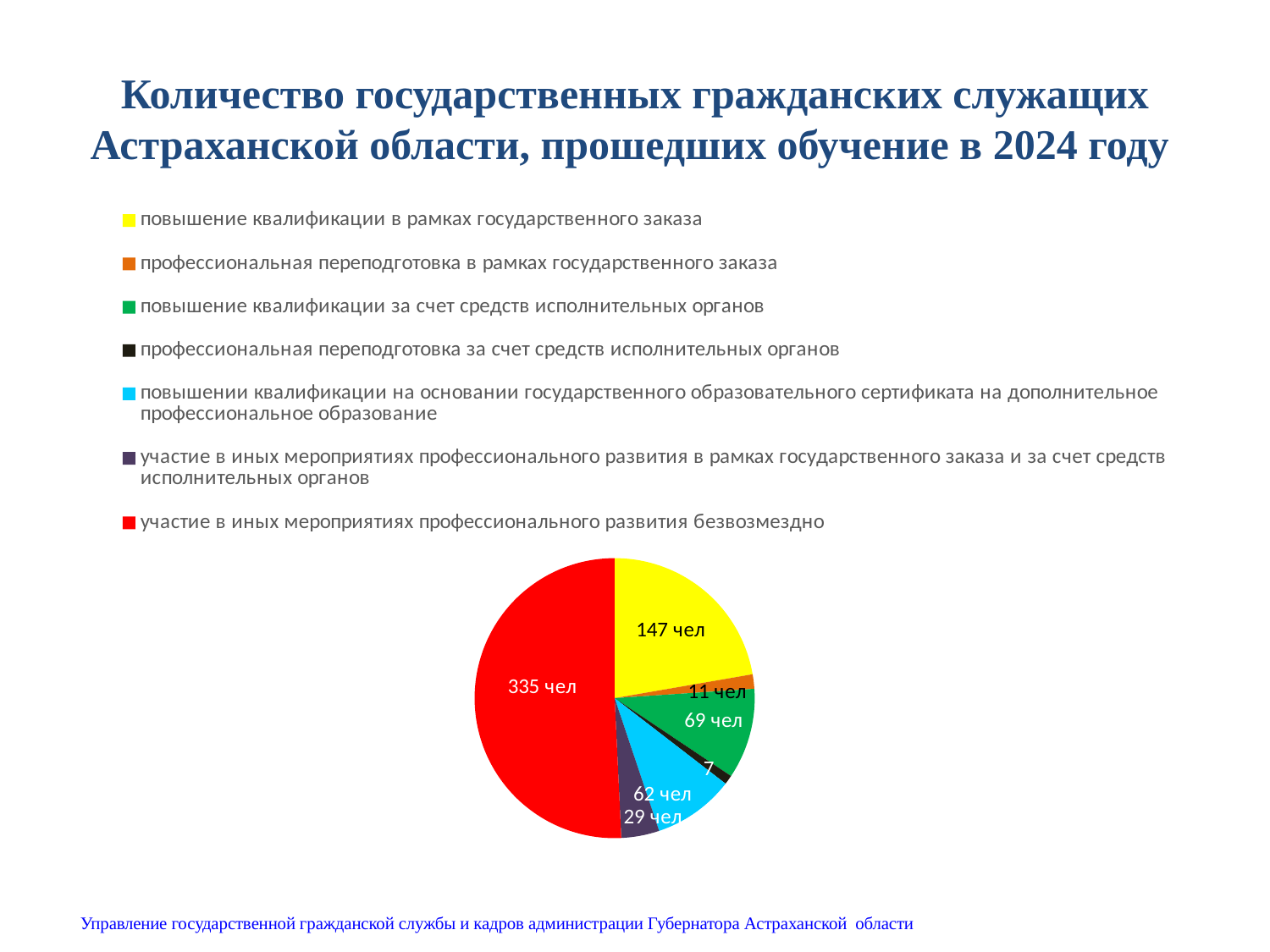
What is the difference between the value for «участие в иных мероприятиях профессионального развития безвозмездно» and the value for «повышение квалификации в рамках государственного заказа»? 188 How many people are shown for «повышении квалификации на основании государственного образовательного сертификата на дополнительное профессиональное образование»? 62 чел What value is shown for «профессиональная переподготовка в рамках государственного заказа»? 11 чел How many people are shown for «повышение квалификации за счет средств исполнительных органов»? 69 чел How many categories does the pie chart contain? 7 Which is larger: «повышение квалификации за счет средств исполнительных органов» or «повышении квалификации на основании государственного образовательного сертификата на дополнительное профессиональное образование»? повышение квалификации за счет средств исполнительных органов What value is labelled on the slice for «профессиональная переподготовка за счет средств исполнительных органов»? 7 How many people are shown for «повышение квалификации в рамках государственного заказа»? 147 чел Which category has the smallest slice of the pie? профессиональная переподготовка за счет средств исполнительных органов Which category has the largest slice of the pie? участие в иных мероприятиях профессионального развития безвозмездно What type of chart is shown on the slide? pie chart What value is labelled on the slice for «участие в иных мероприятиях профессионального развития безвозмездно»? 335 чел